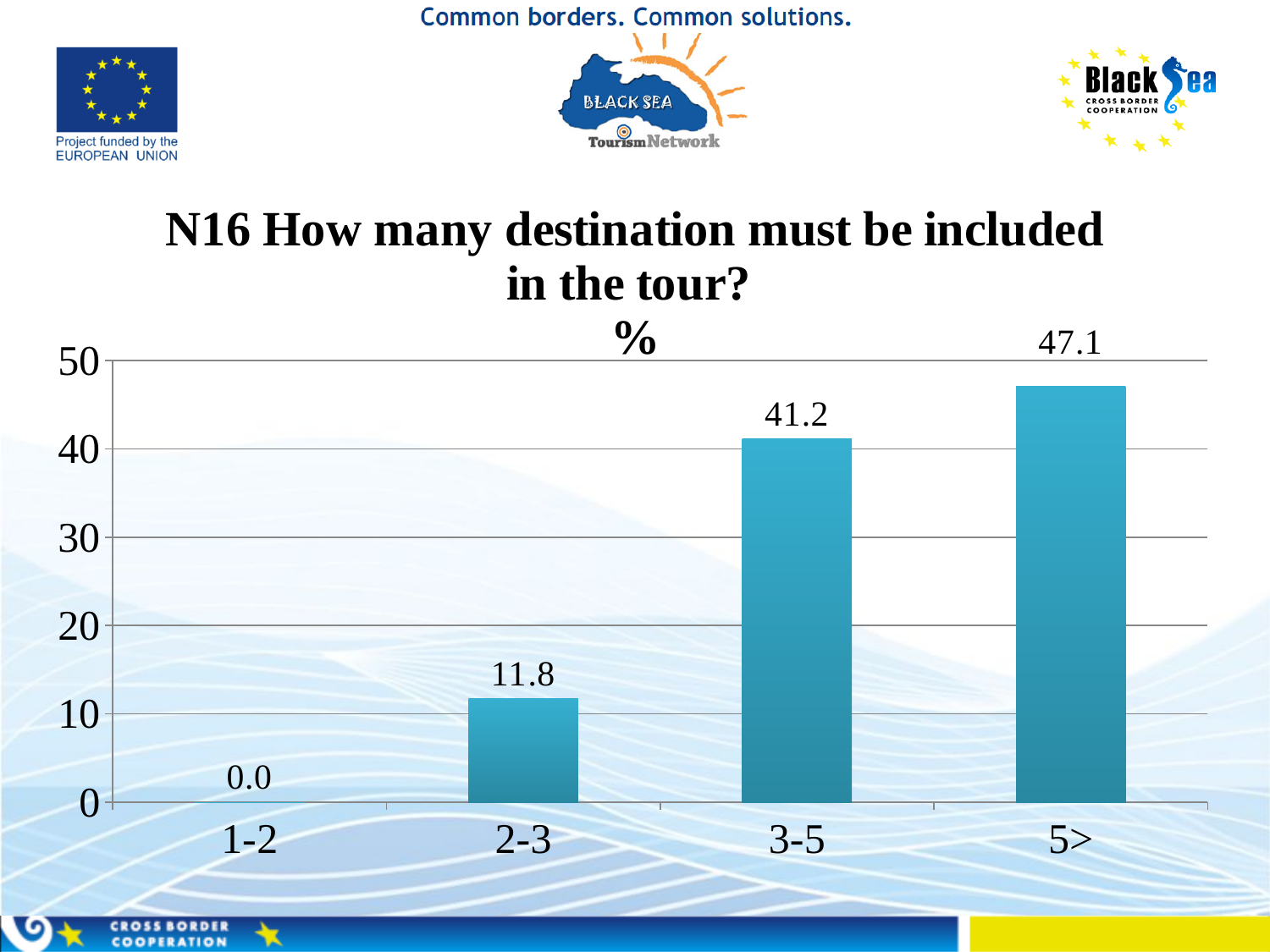
What is the value for the "3-5" category? 41.2 Do the values rise or fall from left to right along the x axis? rise Is the value for "5>" greater or less than 40? greater Which is larger, the value for "2-3" or the value for "3-5"? 3-5 Which category has the lowest value? 1-2 What is the difference between the values for "3-5" and "2-3"? 29.4 What is the difference between the values for "5>" and "3-5"? 5.9 Which category has the highest value? 5> What is the value for the "2-3" category? 11.8 How many categories are shown on the x axis? 4 What kind of chart is shown on the slide? bar chart What is the value for the "1-2" category? 0.0